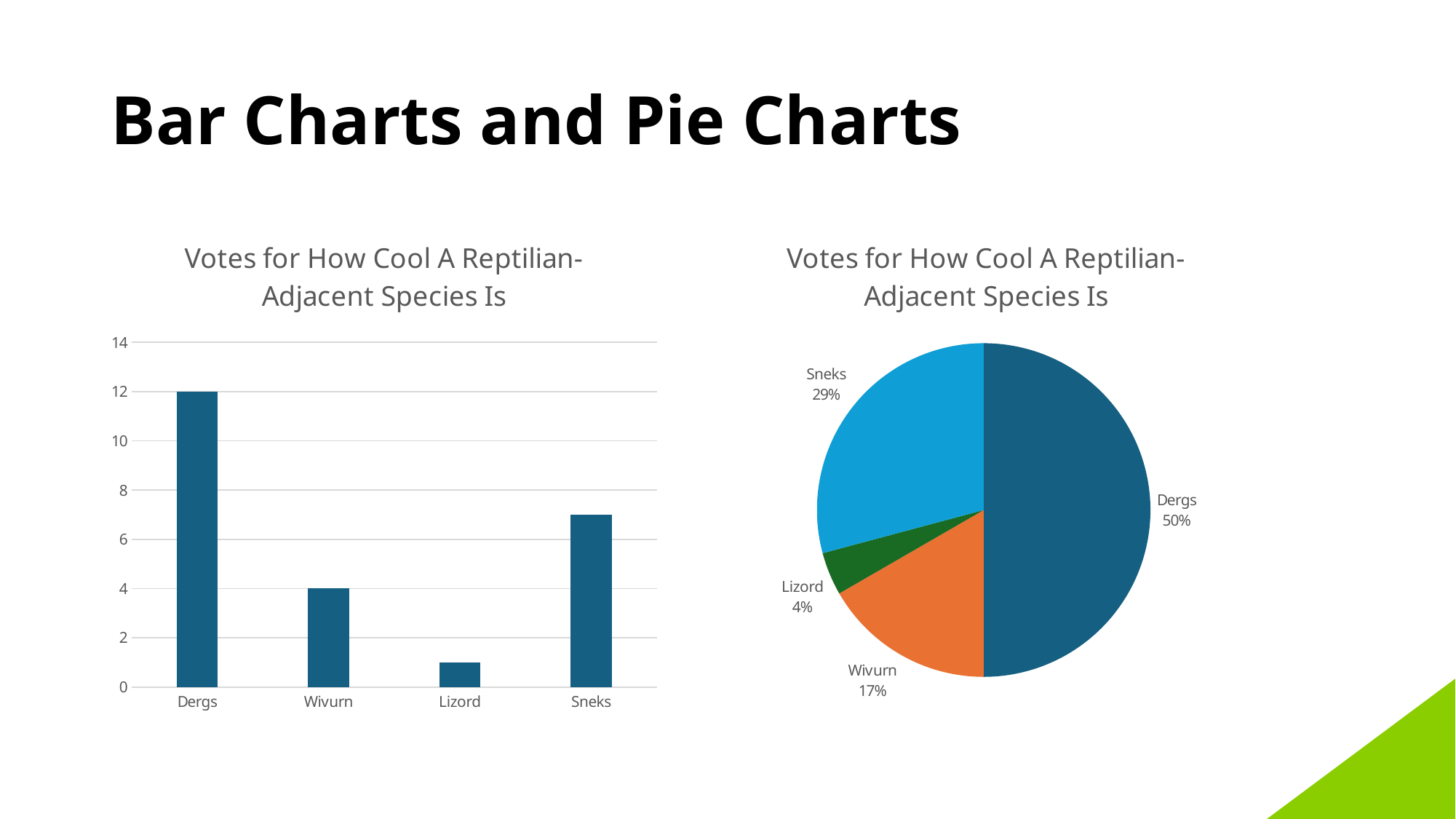
On the left bar chart, how many species are shown on the x axis? 4 On the left bar chart, what is the difference between the votes for Dergs and Wivurn? 8 On the left bar chart, which species has the lowest bar? Lizord On the left bar chart, is the value for Lizord greater or less than 2? less What kind of chart is on the right side of the slide? Pie chart On the right pie chart, what share of the votes does Sneks have? 29% On the right pie chart, what share of the votes does Lizord have? 4% On the left bar chart, which species has the highest bar? Dergs On the left bar chart, how many votes did Wivurn receive? 4 On the left bar chart, how many votes did Dergs receive? 12 On the right pie chart, which is larger, the Wivurn slice or the Sneks slice? Sneks On the left bar chart, is the value for Sneks greater or less than 6? greater